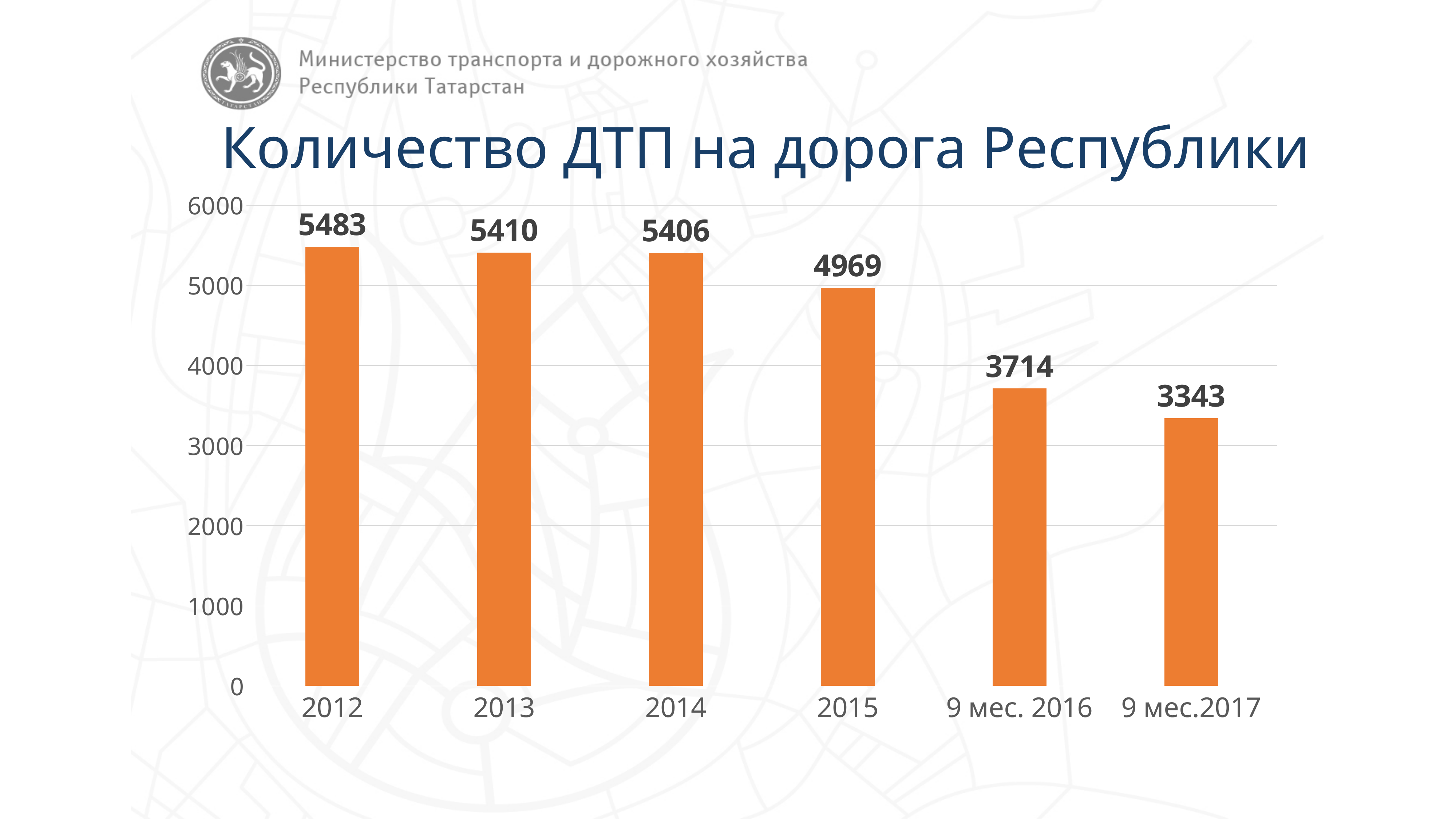
What is the value for 9 мес.2017? 3343 Which is larger, the value for 2015 or the value for 9 мес. 2016? 2015 Which category has the lowest value? 9 мес.2017 What kind of chart is shown on the slide? bar chart What is the value for 2015? 4969 What is the difference between the values for 2014 and 2015? 437 How many categories are shown on the x axis? 6 Is the value for 2013 greater or less than 5000? greater What is the value for 2012? 5483 What is the difference between the values for 9 мес. 2016 and 9 мес.2017? 371 Do the values rise or fall from 2012 to 9 мес.2017? fall Which category has the highest value? 2012